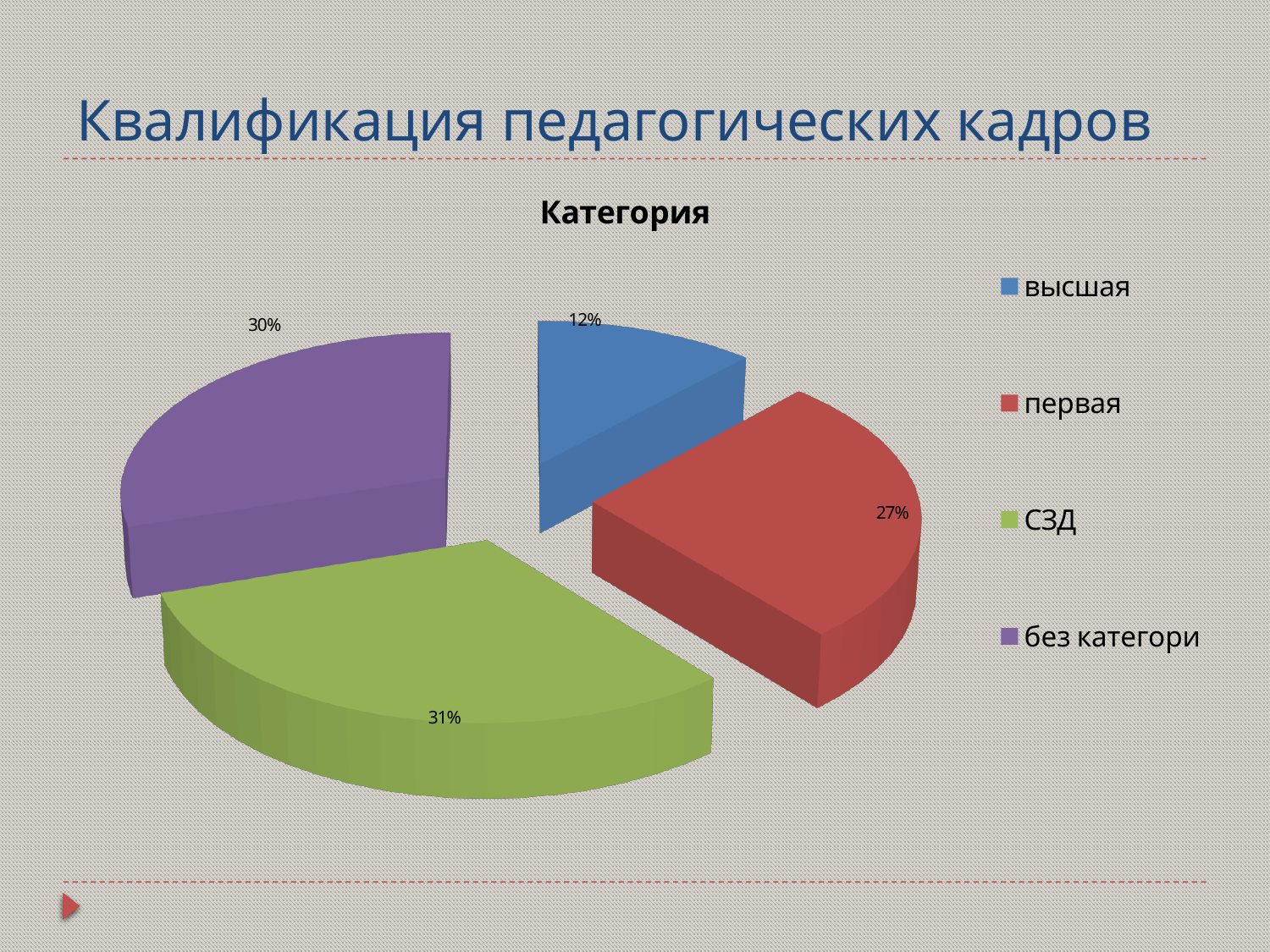
Which category has the largest share of the pie? СЗД How many slices does the pie chart have? 4 What is the value shown for 'первая'? 27% What kind of chart is shown on the slide? pie chart What is the value shown for 'СЗД'? 31% Which category has the smallest share of the pie? высшая What colour is the 'СЗД' slice in the legend? green What is the value shown for 'без категори'? 30% What is the chart's title? Категория Which is larger, the share for 'первая' or the share for 'без категори'? без категори What is the difference between the share for 'СЗД' and the share for 'высшая'? 19% What share of the pie does the 'высшая' slice represent? 12%